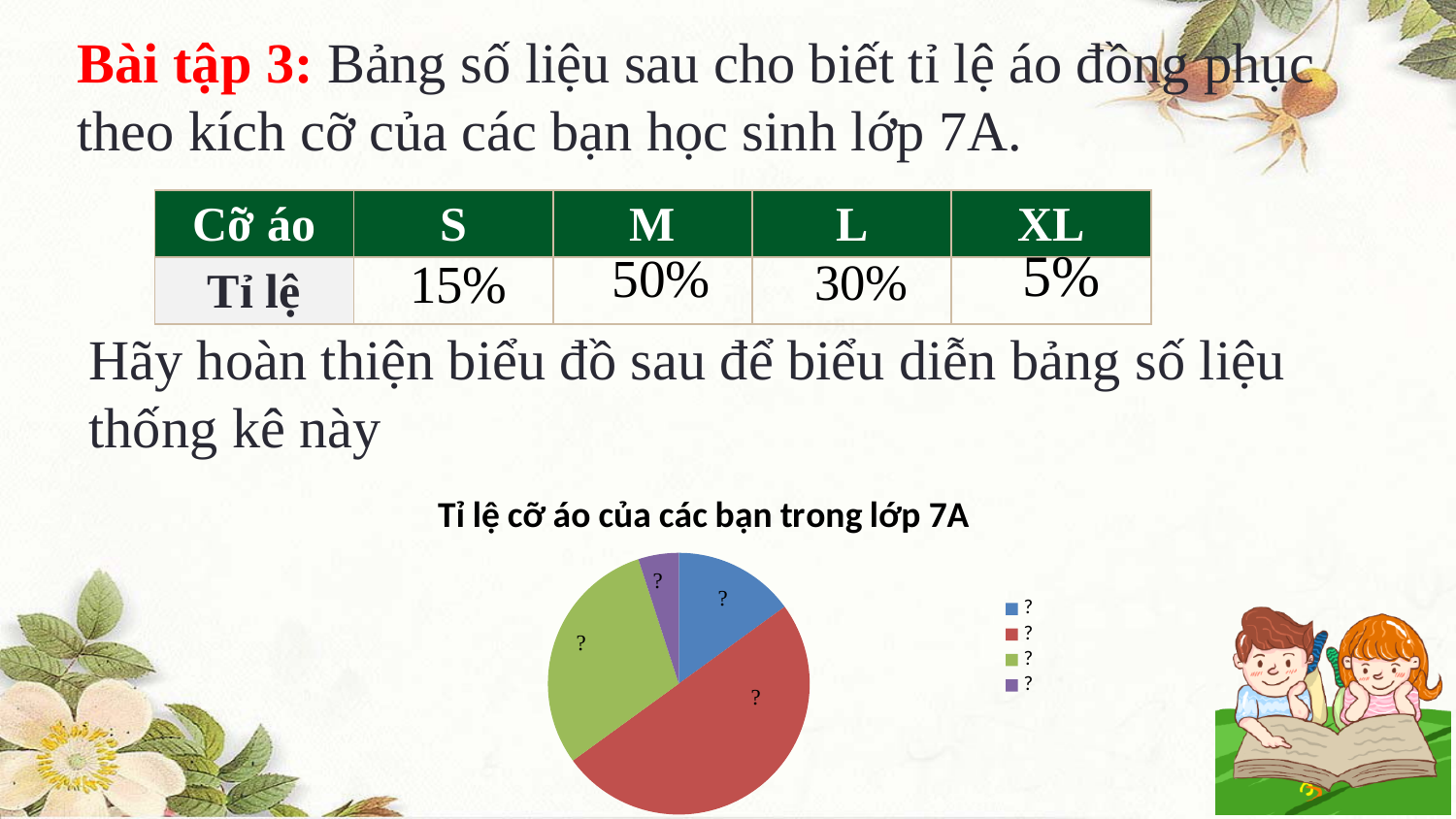
How many entries does the chart's legend list? 4 Which slice is larger, the blue slice or the green slice? green What text is shown as the data label on each slice of the pie chart? ? What is the title of the chart? Tỉ lệ cỡ áo của các bạn trong lớp 7A Which coloured slice of the pie chart is the largest? red Which coloured slice of the pie chart is the smallest? purple What kind of chart is shown on the slide? pie chart Which slice is larger, the red slice or the blue slice? red How many slices does the pie chart have? 4